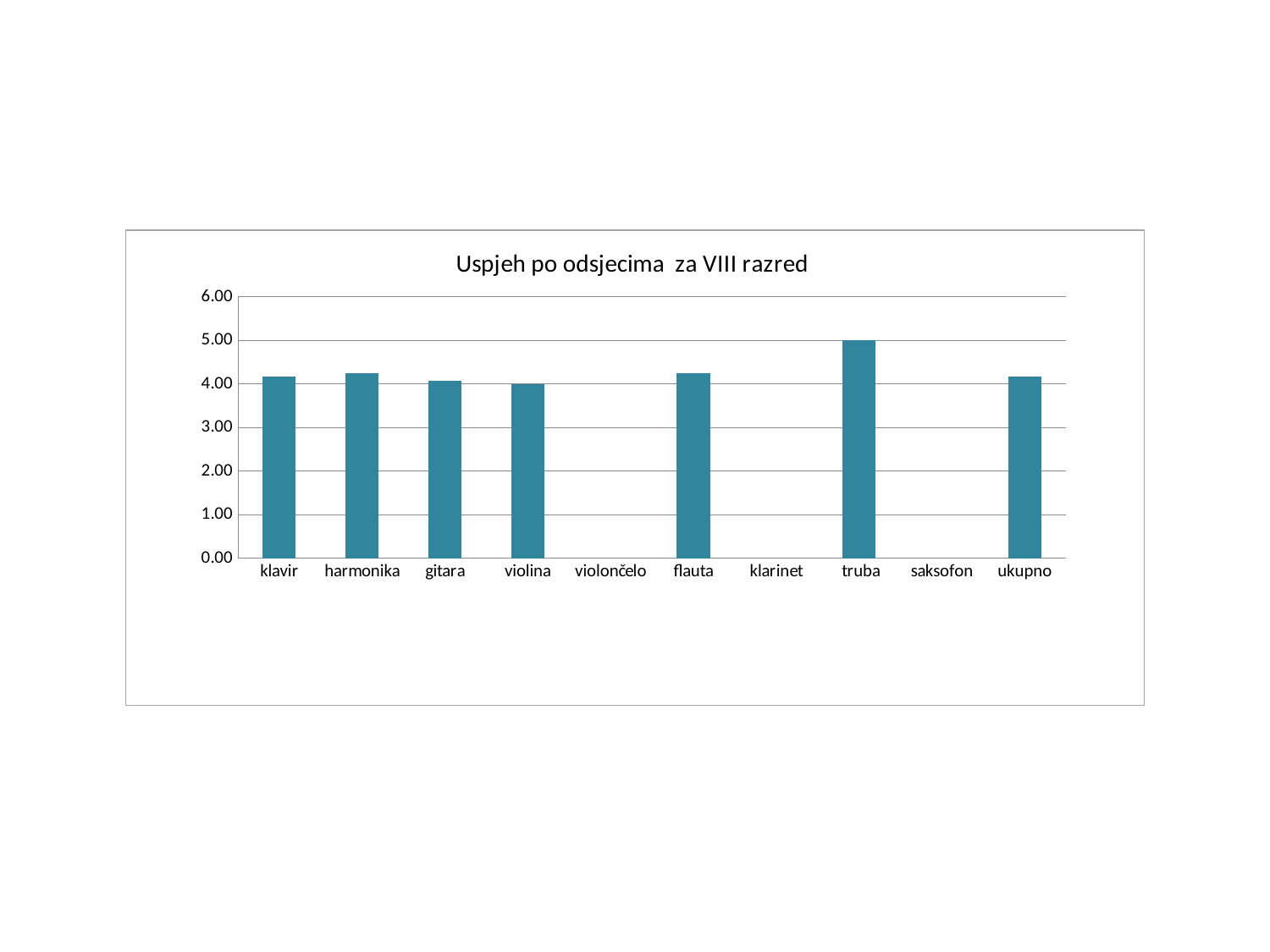
Is the value for gitara greater or less than 3.00? greater How many categories are shown on the x axis of the chart? 10 Which is larger, the value for truba or the value for klavir? truba Is the value for flauta greater or less than 4.00? greater What is the title of the chart? Uspjeh po odsjecima za VIII razred Is the value for truba greater or less than 4.00? greater Which is larger, the value for truba or the value for ukupno? truba What type of chart is shown on the slide? bar chart What is the highest value shown on the y axis of the chart? 6.00 Which category has the highest bar in the chart? truba How many categories on the x axis have no visible bar? 3